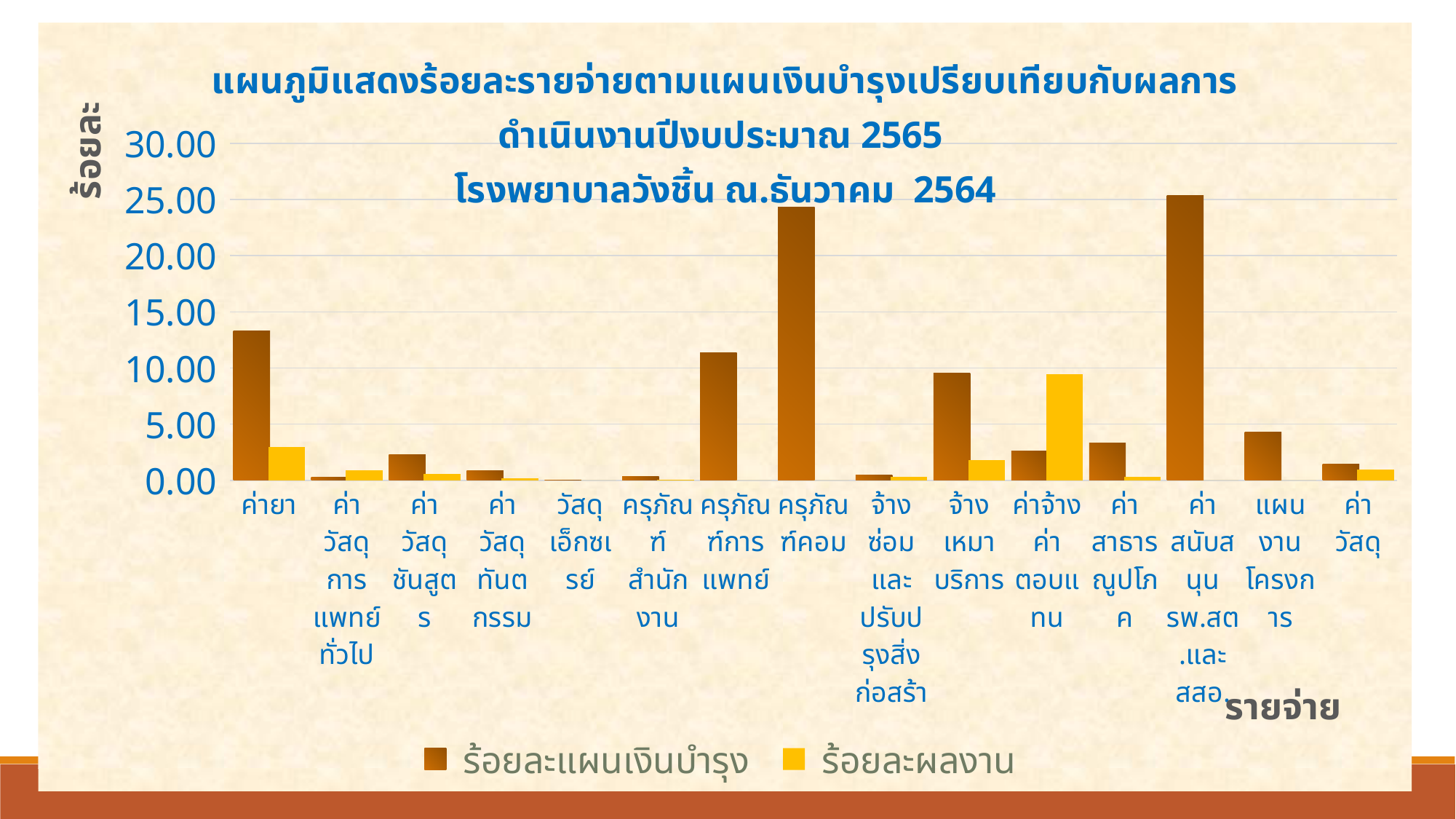
Which category has the highest value for ร้อยละผลงาน? ค่าจ้างค่าตอบแทน What kind of chart is shown on the slide? bar chart For ค่ายา, which series has the larger value, ร้อยละแผนเงินบำรุง or ร้อยละผลงาน? ร้อยละแผนเงินบำรุง Is the ร้อยละแผนเงินบำรุง value for ครุภัณฑ์คอม greater or less than 20.00? greater Is the ร้อยละผลงาน value for ค่าจ้างค่าตอบแทน greater or less than 10.00? less Is the ร้อยละแผนเงินบำรุง value for ค่ายา greater or less than 10.00? greater How many expense categories are shown on the x axis? 15 How many series does the legend list? 2 What is the label on the vertical axis of the chart? ร้อยละ Which category has the highest value for ร้อยละแผนเงินบำรุง? ค่าสนับสนุน รพ.สต.และ สสอ. For ค่าจ้างค่าตอบแทน, which series has the larger value, ร้อยละแผนเงินบำรุง or ร้อยละผลงาน? ร้อยละผลงาน